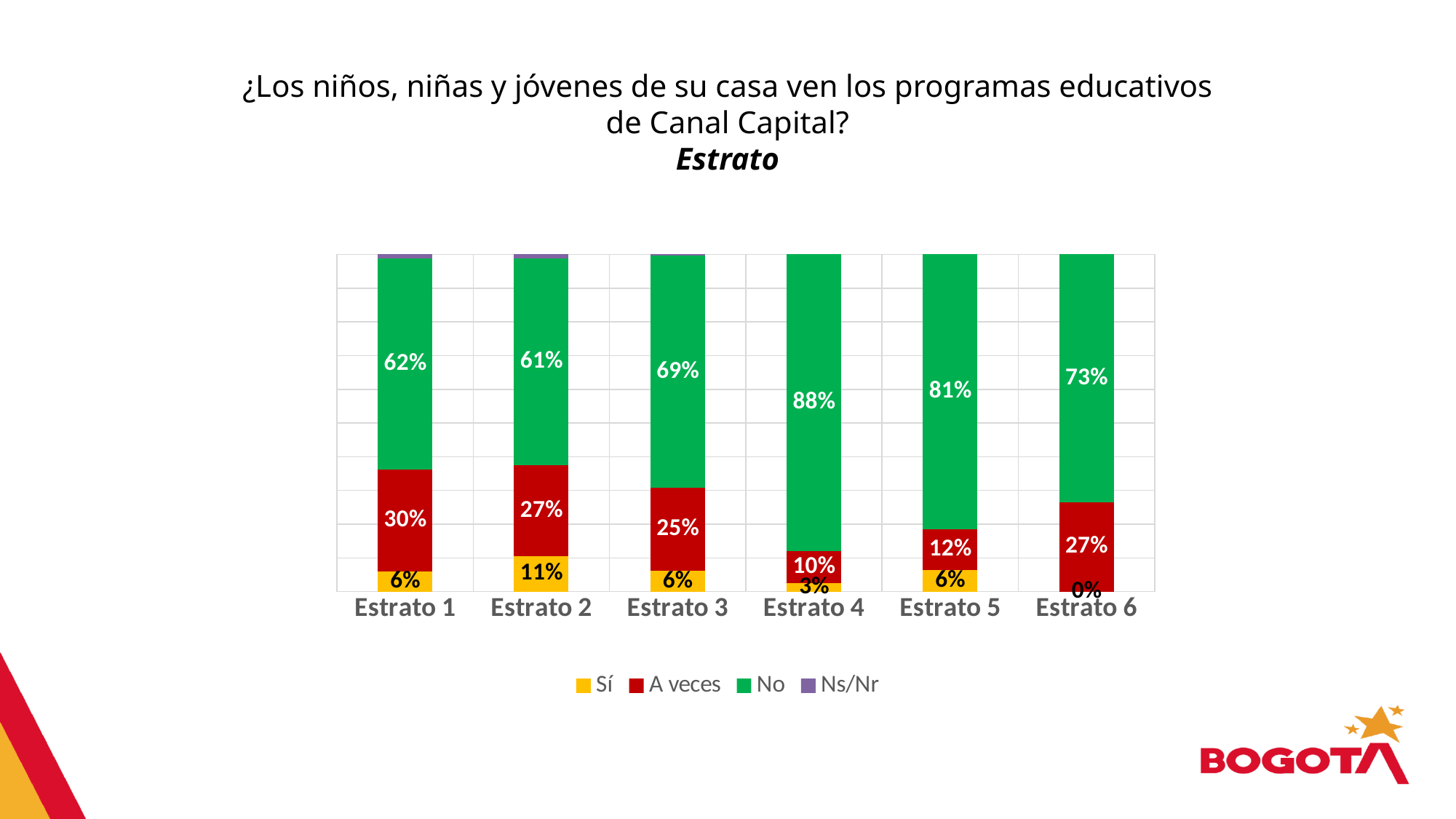
What is the "A veces" value for Estrato 1? 30% What is the difference between the "No" values for Estrato 4 and Estrato 1? 26% Which estrato has the lowest "Sí" value? Estrato 6 Which is larger, the "A veces" value for Estrato 3 or for Estrato 5? Estrato 3 What is the "Sí" value for Estrato 2? 11% What kind of chart is shown on the slide? Stacked bar chart What percentage of respondents in Estrato 4 answered "No"? 88% How many series does the legend list? 4 Which estrato has the lowest "A veces" value? Estrato 4 Which estrato has the highest "No" value? Estrato 4 What is the "A veces" value for Estrato 6? 27% How many estrato categories are shown on the x axis? 6